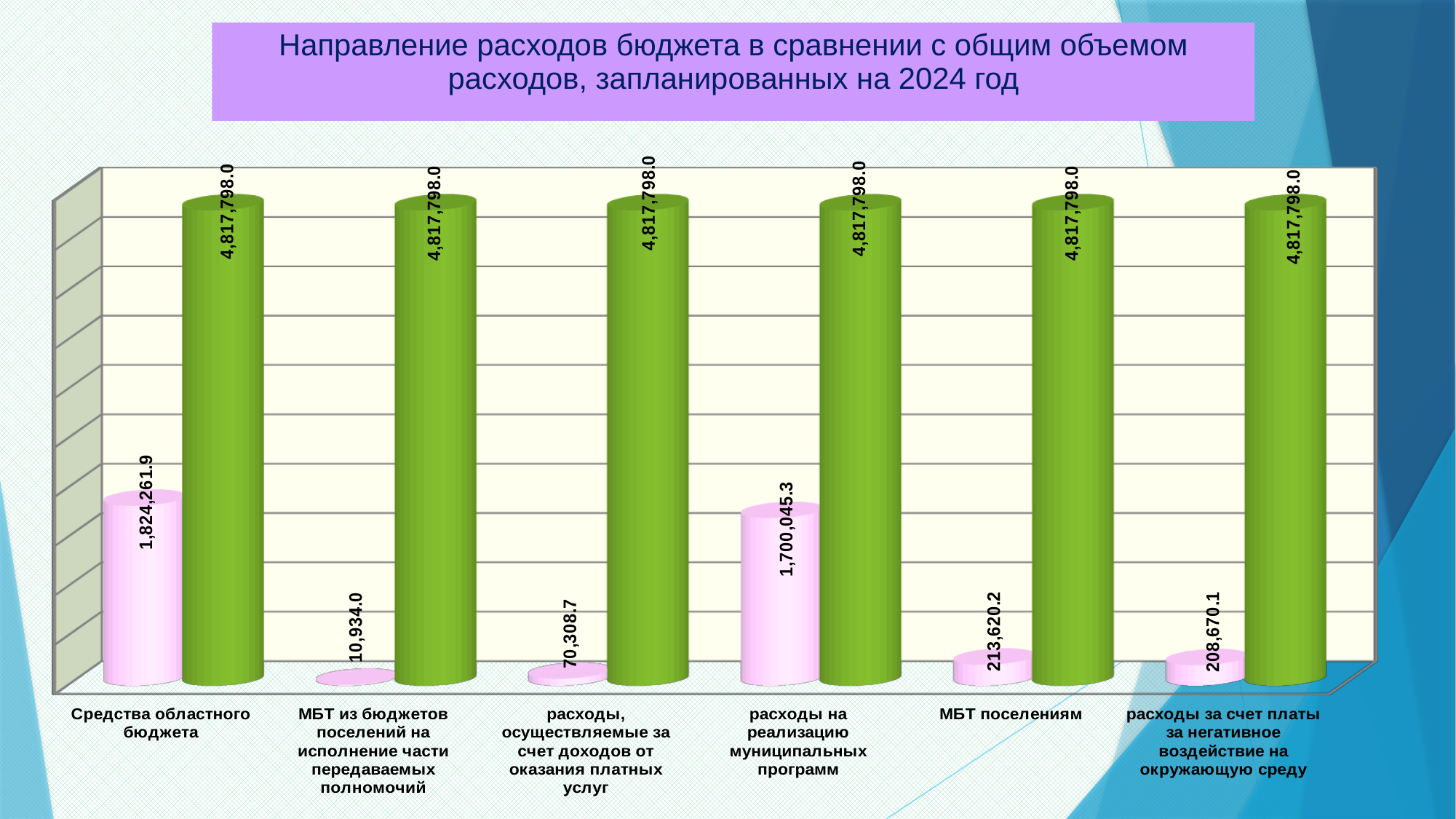
What is the value of the pink bar for "Средства областного бюджета"? 1,824,261.9 What is the value of the pink bar for "расходы на реализацию муниципальных программ"? 1,700,045.3 What kind of chart is shown on the slide? Bar chart Which category has the highest pink bar? Средства областного бюджета Which category has the lowest pink bar? МБТ из бюджетов поселений на исполнение части передаваемых полномочий What is the difference between the pink bars for "Средства областного бюджета" and "расходы на реализацию муниципальных программ"? 124,216.6 What is the value of the pink bar for "МБТ поселениям"? 213,620.2 How many categories are shown on the x axis? 6 What is the difference between the green bar and the pink bar for "Средства областного бюджета"? 2,993,536.1 What is the value of the pink bar for "расходы за счет платы за негативное воздействие на окружающую среду"? 208,670.1 What value is shown on each of the green bars? 4,817,798.0 Which pink bar is larger: "МБТ поселениям" or "расходы за счет платы за негативное воздействие на окружающую среду"? МБТ поселениям